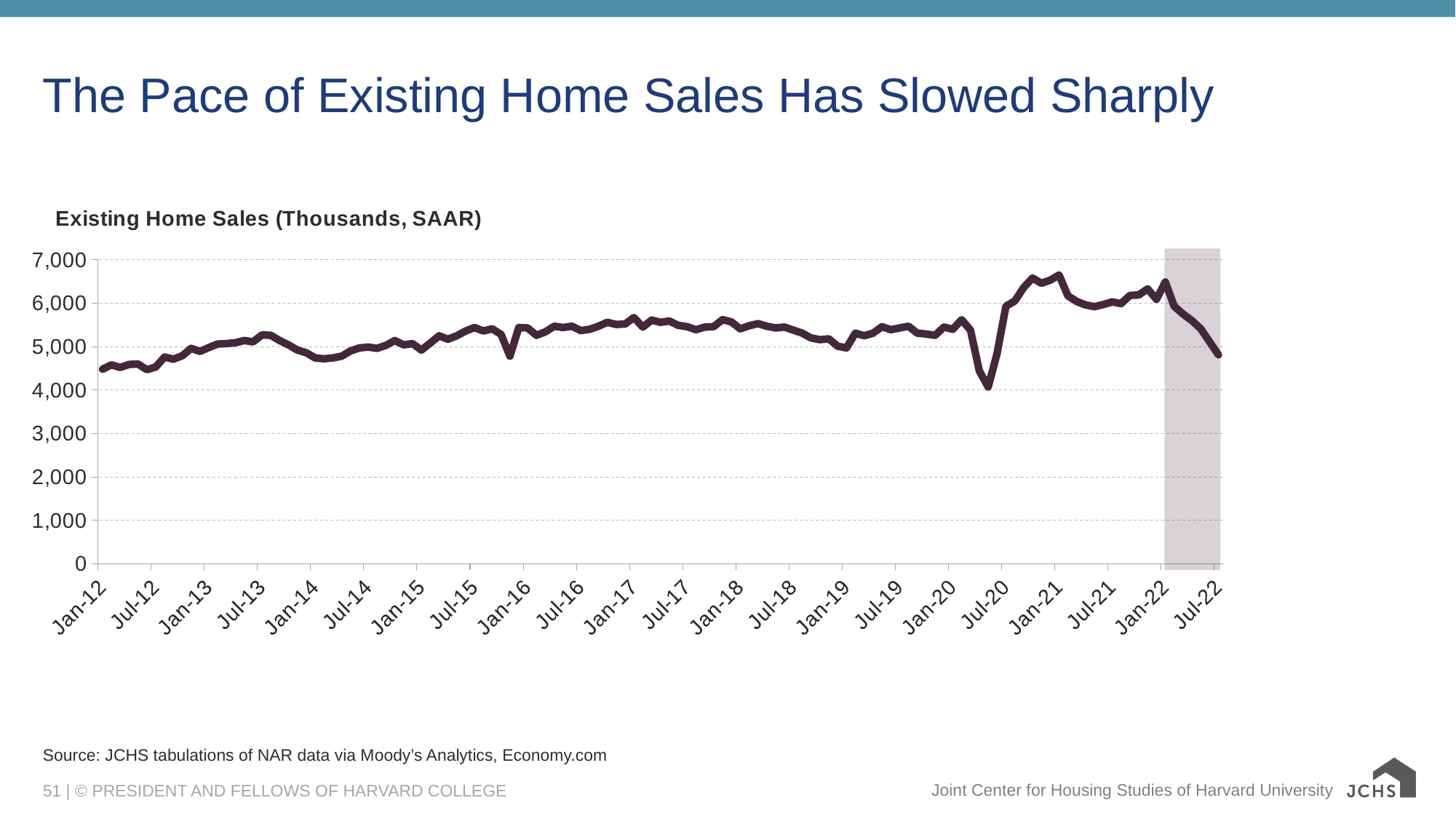
Is the value for Jan-12 greater or less than 4,000? greater Is the value for Jul-22 greater or less than 5,000? less What kind of chart is shown on the slide? line chart Is the value for Jan-12 greater or less than 5,000? less Do existing home sales rise or fall between Jan-22 and Jul-22? fall What is the title of the chart? Existing Home Sales (Thousands, SAAR) Which is larger, the value for Jan-21 or the value for Jul-22? Jan-21 What is the highest value shown on the vertical axis? 7,000 In which year does the line reach its lowest point? 2020